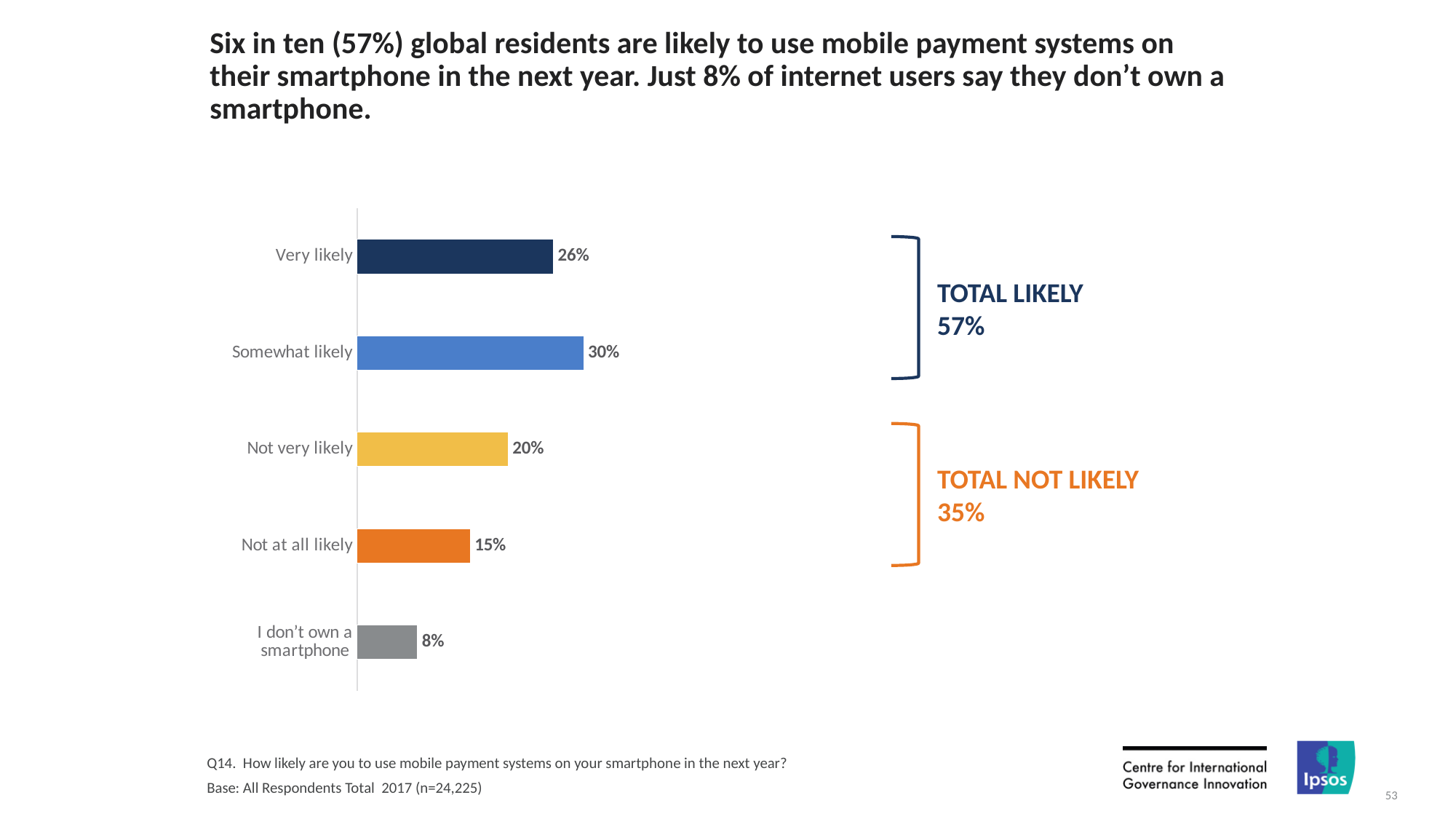
How many categories are shown in the chart? 5 What is the difference between 'Not very likely' and 'Not at all likely'? 5% What is the value for 'Somewhat likely'? 30% What is the difference between 'Somewhat likely' and 'Very likely'? 4% What is the 'TOTAL NOT LIKELY' percentage shown next to the chart? 35% What percentage of respondents say they don't own a smartphone? 8% What is the value for 'Not at all likely'? 15% Which is larger, 'Not very likely' or 'Not at all likely'? Not very likely What percentage of respondents are very likely to use mobile payment systems on their smartphone in the next year? 26% What kind of chart is shown on the slide? Bar chart Which category has the lowest value? I don't own a smartphone Which category has the highest value? Somewhat likely